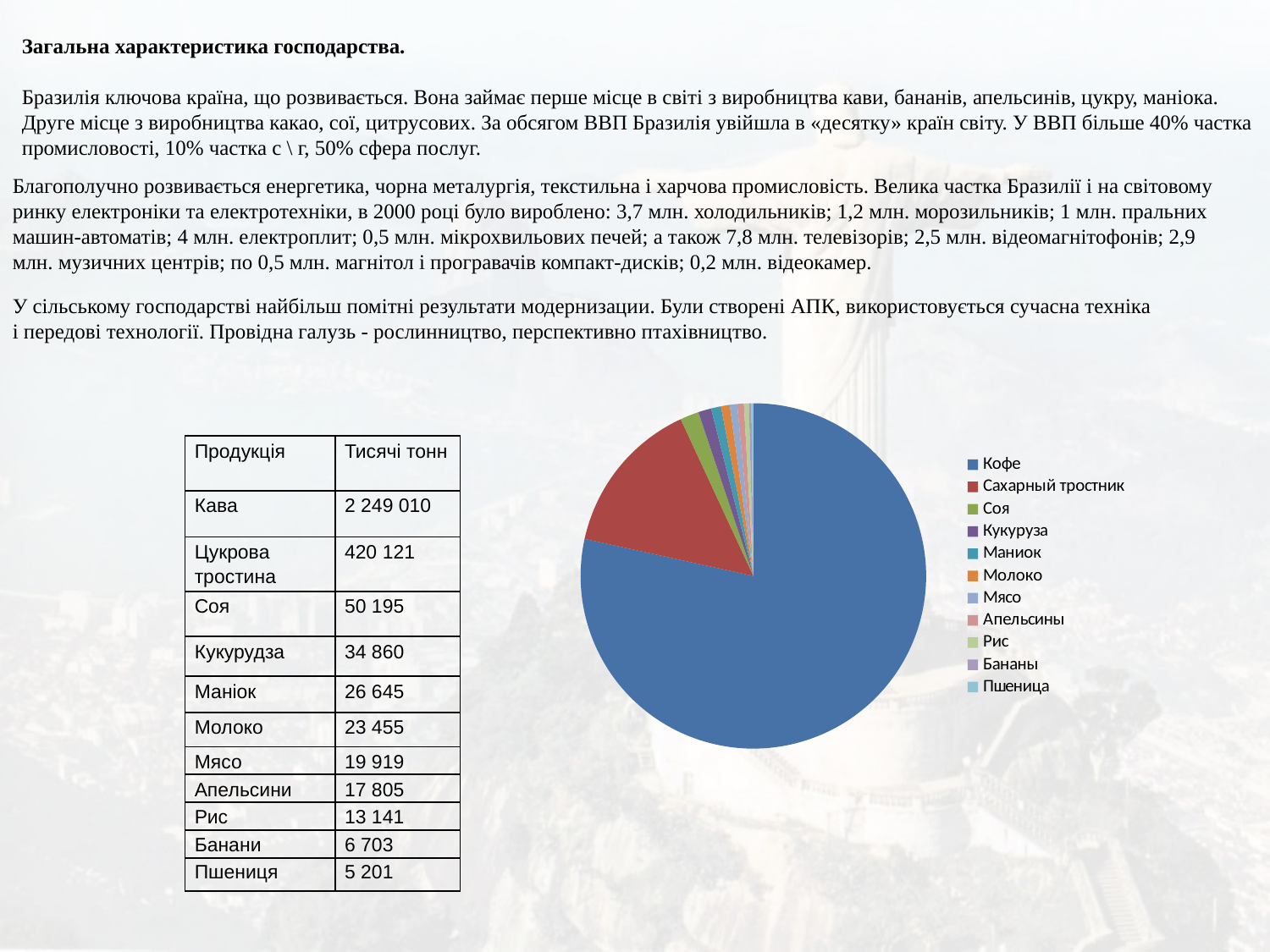
Using the table next to the pie chart, what is the difference between the values for Кава and Цукрова тростина? 1 828 889 What kind of chart is shown on the slide? pie chart Which category has the largest slice in the pie chart? Кофе Which category has the second-largest slice in the pie chart? Сахарный тростник According to the table next to the pie chart, what is the value for Пшениця (wheat) in thousand tonnes? 5 201 How many slices does the pie chart have? 11 According to the table next to the pie chart, what is the value for Кава (coffee) in thousand tonnes? 2 249 010 According to the table next to the pie chart, what is the value for Соя in thousand tonnes? 50 195 According to the table next to the pie chart, what is the value for Цукрова тростина (sugar cane) in thousand tonnes? 420 121 What colour is the slice for Кофе in the pie chart? blue Which is larger in the pie chart, the slice for Кофе or the slice for Сахарный тростник? Кофе How many entries does the legend of the pie chart list? 11